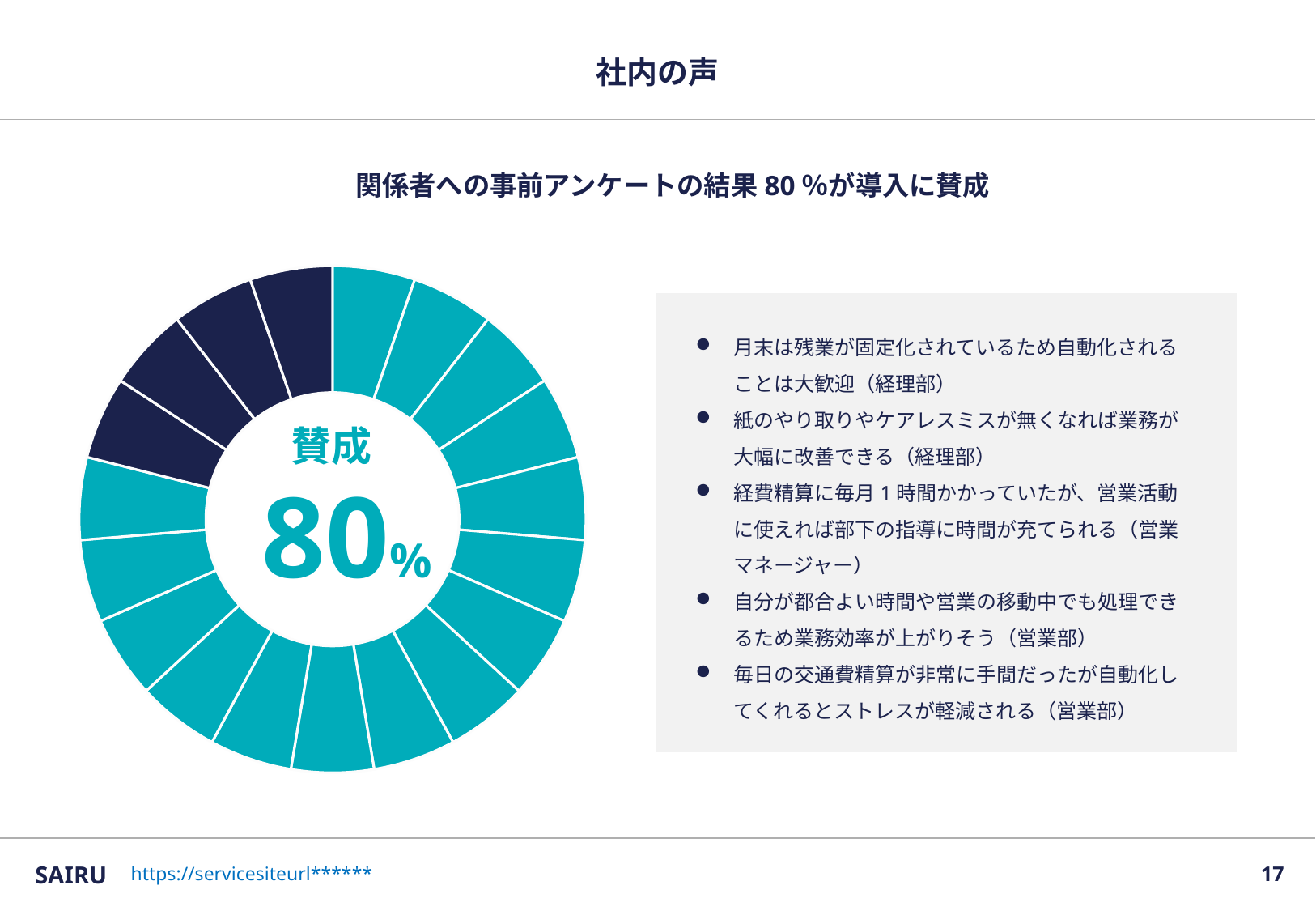
How many dark navy segments are there in the donut chart? 4 What label appears above the percentage in the centre of the donut chart? 賛成 According to the heading above the chart, what percentage of stakeholders were in favour of the introduction? 80 % Which colour covers the larger portion of the donut chart, teal or dark navy? teal Is the share for 賛成 greater or less than 50%? greater What share of the donut chart does 賛成 (in favour) represent? 80% How many teal segments are there in the donut chart? 15 What percentage is shown in the centre of the donut chart? 80% What kind of chart is shown on the left of the slide? Pie chart (donut) What share of the donut chart is taken by the dark navy segments (not in favour)? 20% What is the title of the slide containing the donut chart? 社内の声 How many individual segments make up the donut chart in total? 19